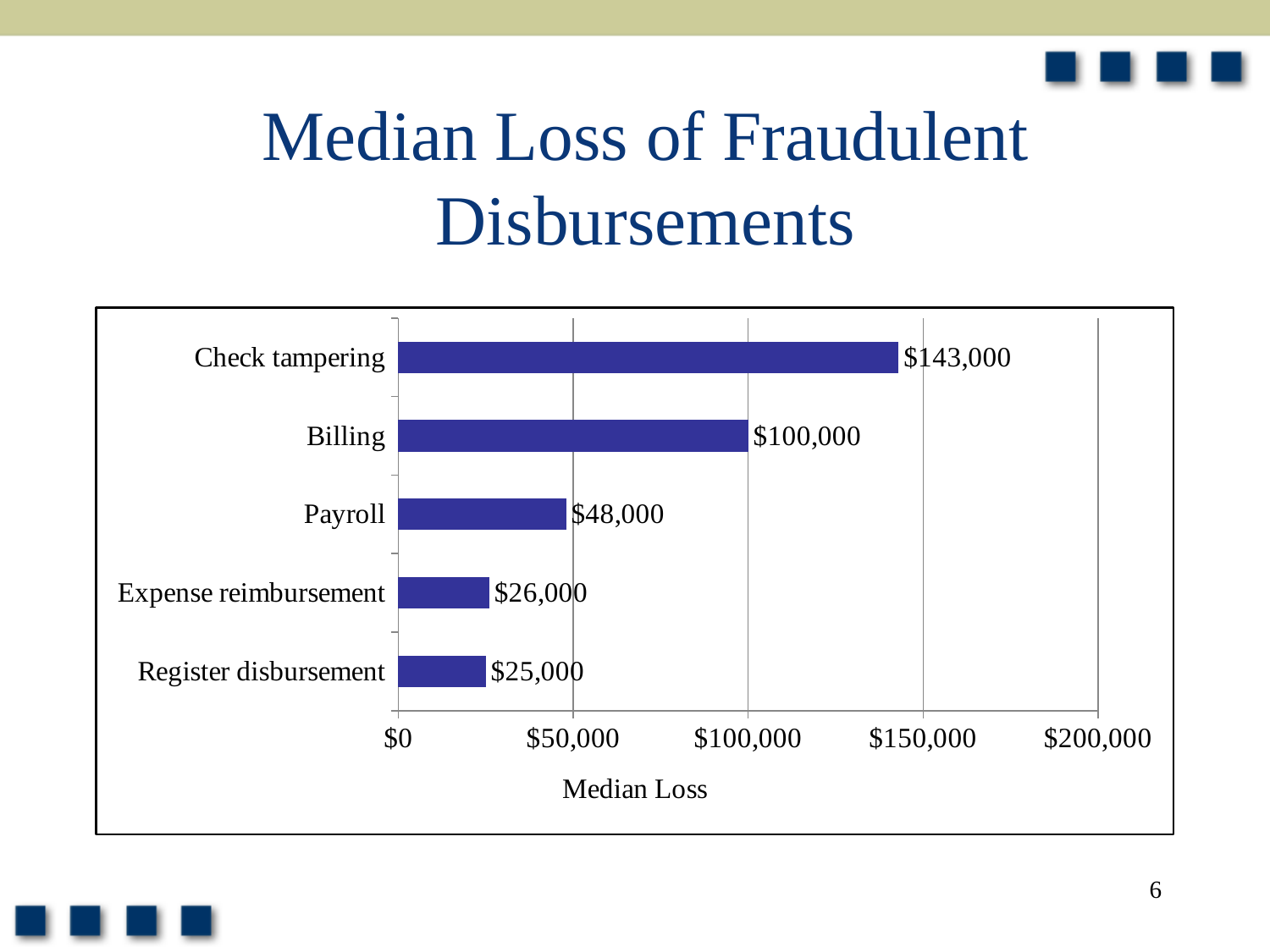
Which category has the lowest median loss? Register disbursement Is the median loss for Check tampering greater or less than $150,000? less What is the median loss for Expense reimbursement? $26,000 What is the median loss for Check tampering? $143,000 What is the label of the horizontal axis? Median Loss What is the difference between the median loss for Billing and Payroll? $52,000 Which has a larger median loss, Payroll or Expense reimbursement? Payroll What is the difference between the median loss for Check tampering and Billing? $43,000 How many categories are shown in the chart? 5 What is the median loss for Payroll? $48,000 Which category has the highest median loss? Check tampering What kind of chart is shown on the slide? bar chart